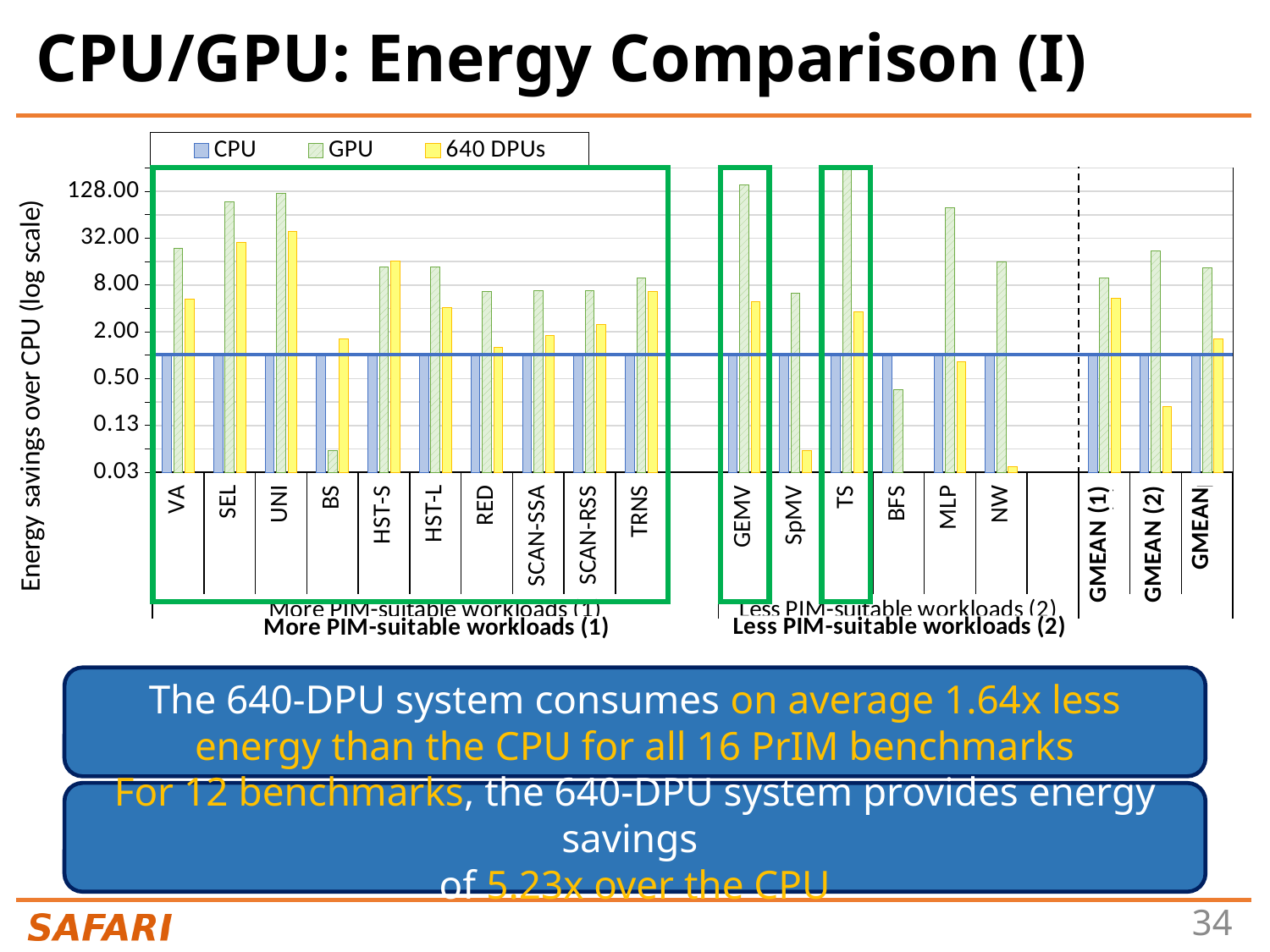
How many series does the chart legend list? 3 Is the 640 DPUs value for UNI greater or less than 32.00? greater Which series are listed in the chart legend? CPU, GPU, 640 DPUs What kind of chart is shown on the slide? bar chart How many categories are shown along the x-axis of the chart? 19 For BS, which is larger: the GPU value or the 640 DPUs value? 640 DPUs Which category has the highest 640 DPUs value? UNI Is the 640 DPUs value for NW greater or less than 0.13? less What is the label of the y-axis? Energy savings over CPU (log scale) Is the GPU value for BS greater or less than 0.13? less Which category has the lowest GPU value? BS